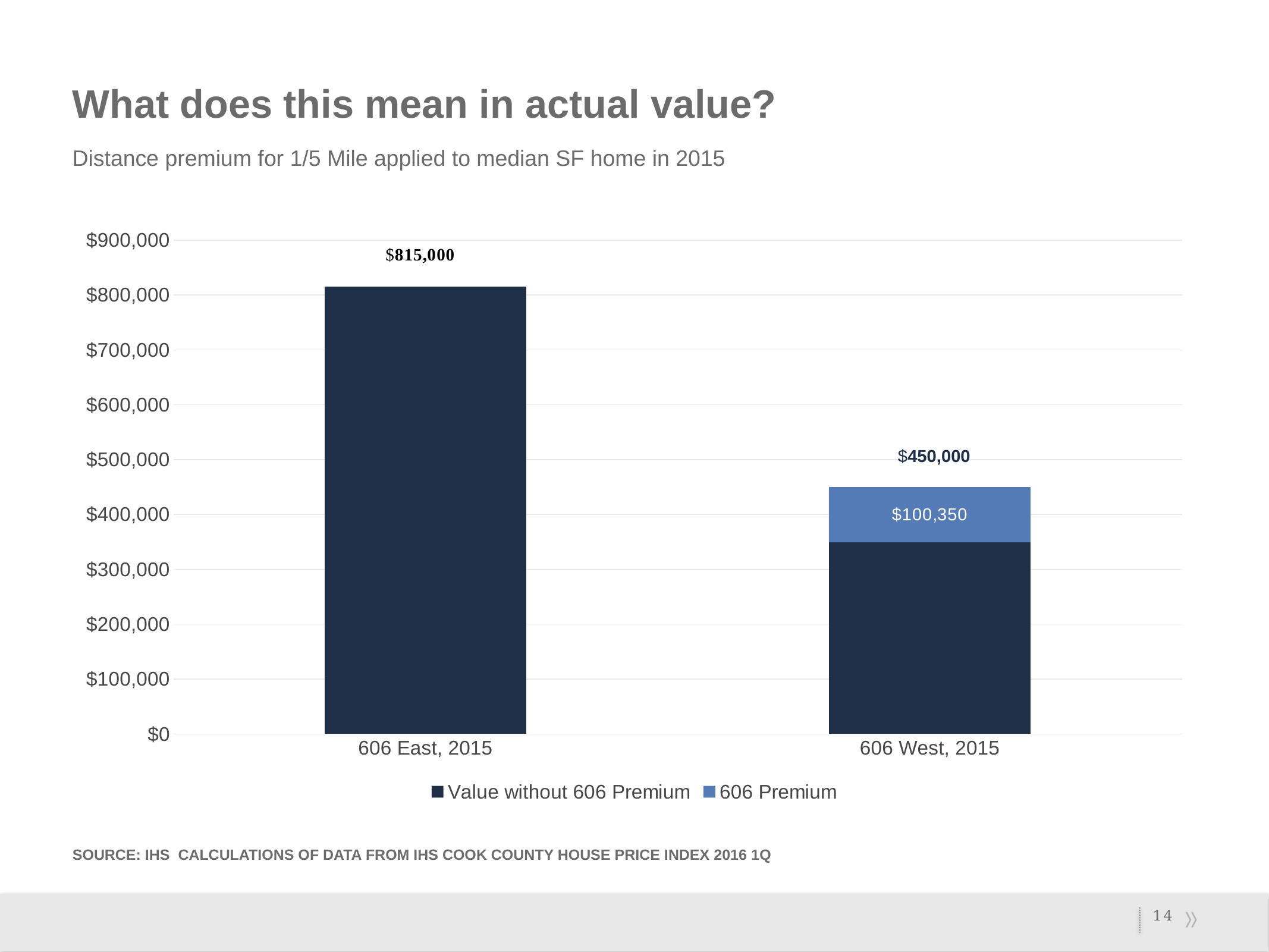
What is the value of the 606 Premium segment for 606 West, 2015? $100,350 Which category has the highest total value? 606 East, 2015 Is the Value without 606 Premium for 606 West, 2015 greater or less than $300,000? greater What is the total value labelled for 606 West, 2015? $450,000 What is the total value labelled for 606 East, 2015? $815,000 Which is larger, the total value for 606 East, 2015 or for 606 West, 2015? 606 East, 2015 How many categories are shown on the x axis of the chart? 2 What is the subtitle describing the chart on the slide? Distance premium for 1/5 Mile applied to median SF home in 2015 What are the two series listed in the chart's legend? Value without 606 Premium; 606 Premium What kind of chart is shown on the slide? bar chart How many series does the chart's legend list? 2 What is the difference between the total value for 606 East, 2015 and the total value for 606 West, 2015? $365,000